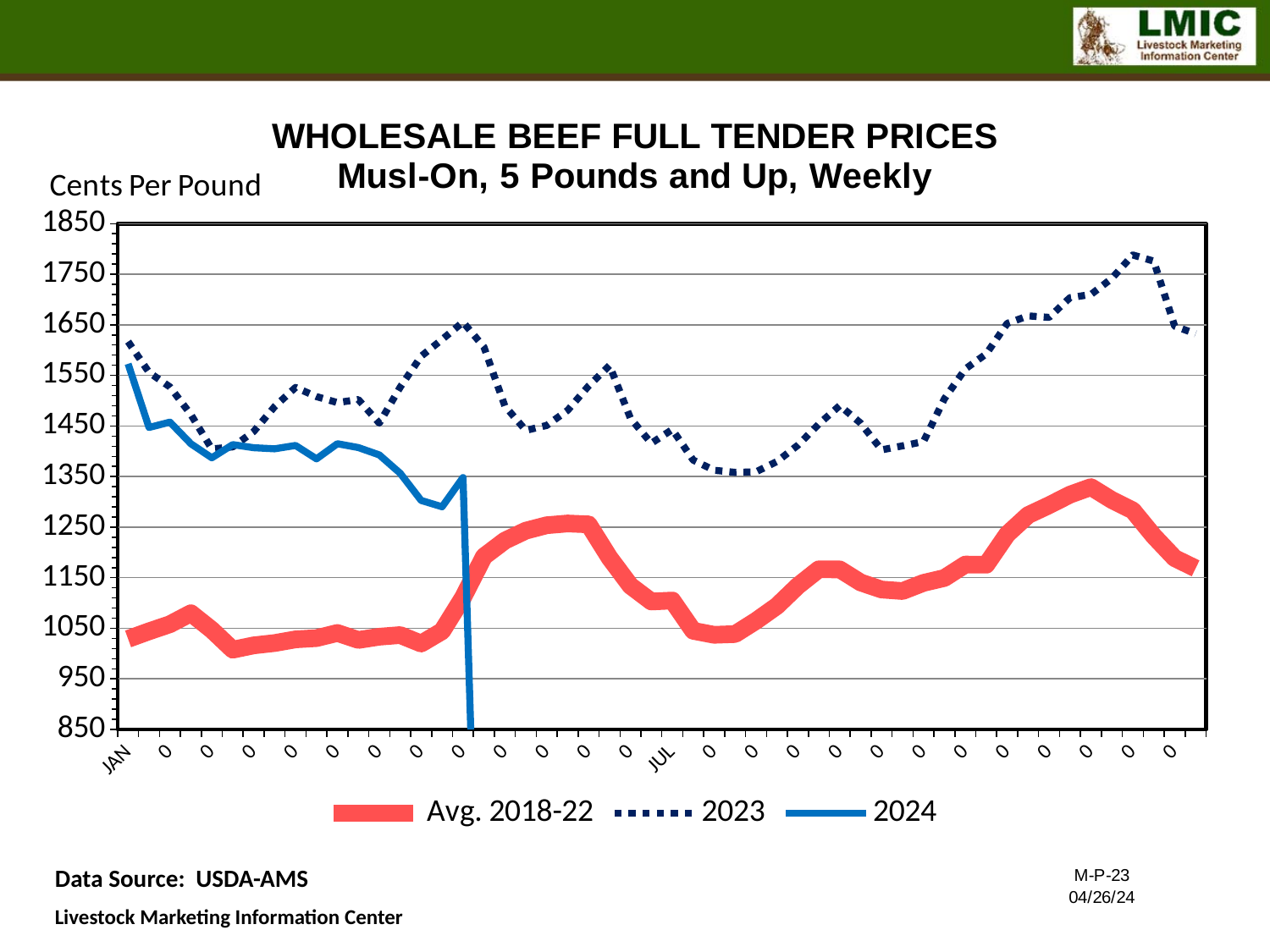
What unit is shown on the vertical axis label? Cents Per Pound Is the value of the Avg. 2018-22 series at JUL greater or less than 1250? less What are the three series named in the legend? Avg. 2018-22, 2023, 2024 Is the value of the Avg. 2018-22 series at JAN greater or less than 1150? less Is the value of the 2023 series at JAN greater or less than 1550? greater At JAN, which is larger: the 2023 series or the Avg. 2018-22 series? 2023 How many series does the legend list? 3 What kind of chart is shown on the slide? line chart Does the 2024 series rise or fall from JAN to its last plotted week? fall Which series stays lowest across the whole chart? Avg. 2018-22